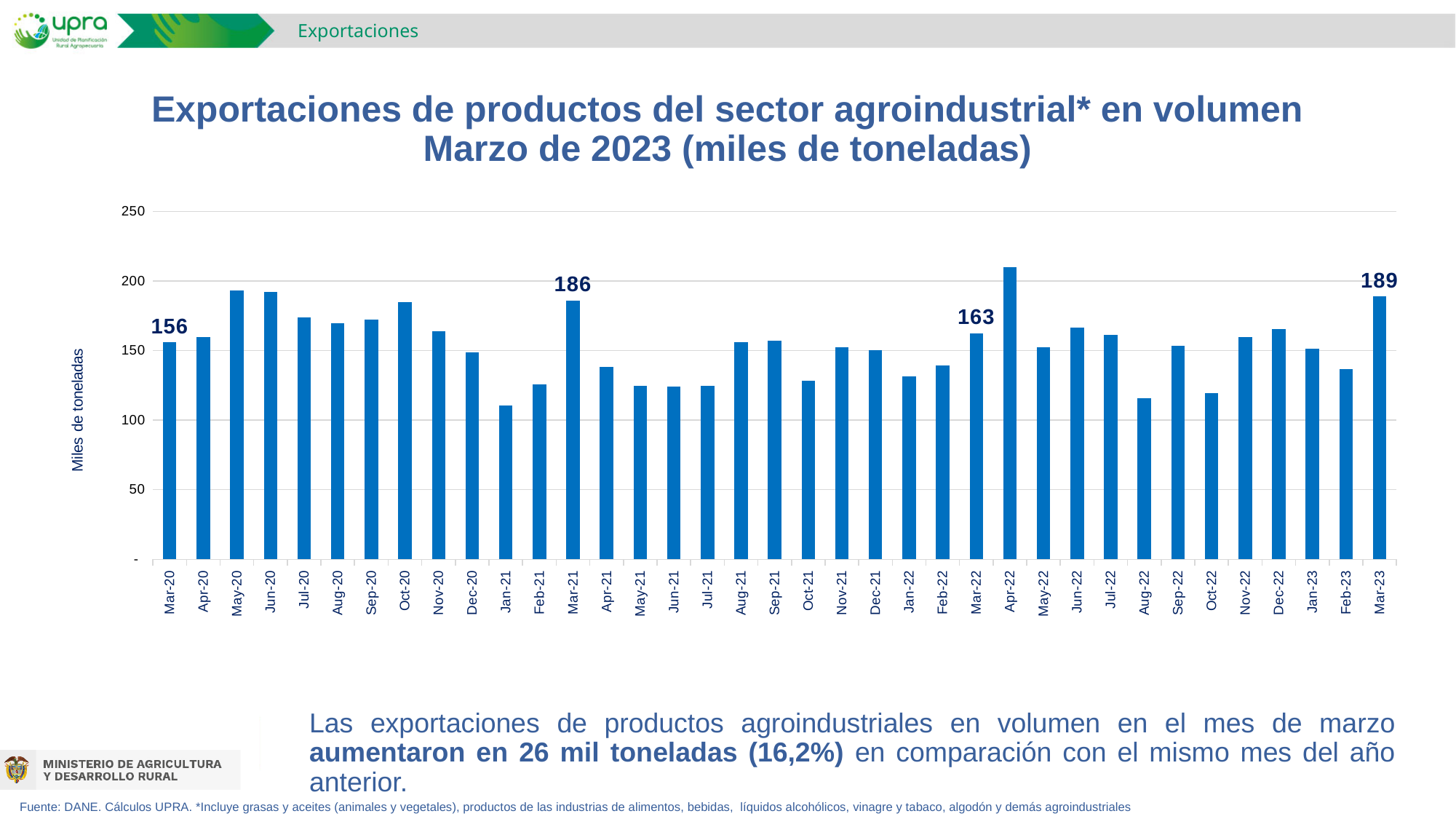
What is the value for Mar-21? 186 What is the value for Mar-23? 189 What kind of chart is shown on the slide? Bar chart How many monthly bars are plotted in the chart? 37 Which month has the lowest bar? Jan-21 Is the value for Apr-22 greater or less than 200? greater What is the value for Mar-22? 163 What is the difference between the values for Mar-23 and Mar-22? 26 Is the value for Aug-22 greater or less than 150? less Which month has the highest bar? Apr-22 What is the value for Mar-20? 156 Which is larger, the value for Mar-21 or the value for Mar-22? Mar-21